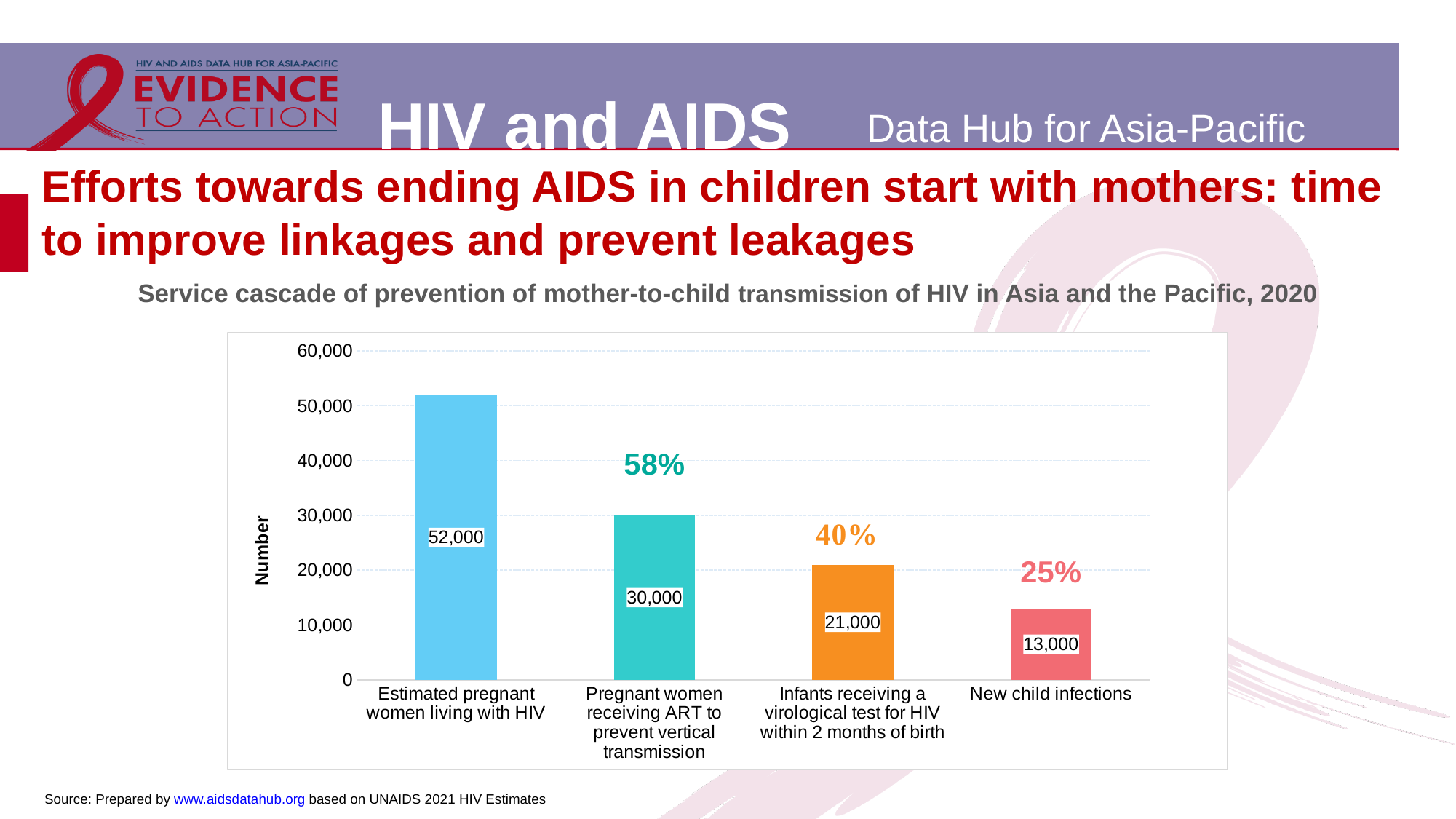
What is the difference between Estimated pregnant women living with HIV and Pregnant women receiving ART to prevent vertical transmission? 22,000 Which category has the highest value? Estimated pregnant women living with HIV Do the values rise or fall from left to right along the x axis? Fall What percentage is printed above the bar for Pregnant women receiving ART to prevent vertical transmission? 58% What kind of chart is shown? Bar chart What is the value for New child infections? 13,000 What is the value for Pregnant women receiving ART to prevent vertical transmission? 30,000 What is the value for Estimated pregnant women living with HIV? 52,000 Which category has the lowest value? New child infections Which is larger: Infants receiving a virological test for HIV within 2 months of birth or New child infections? Infants receiving a virological test for HIV within 2 months of birth What is the value for Infants receiving a virological test for HIV within 2 months of birth? 21,000 How many categories are shown on the x axis? 4